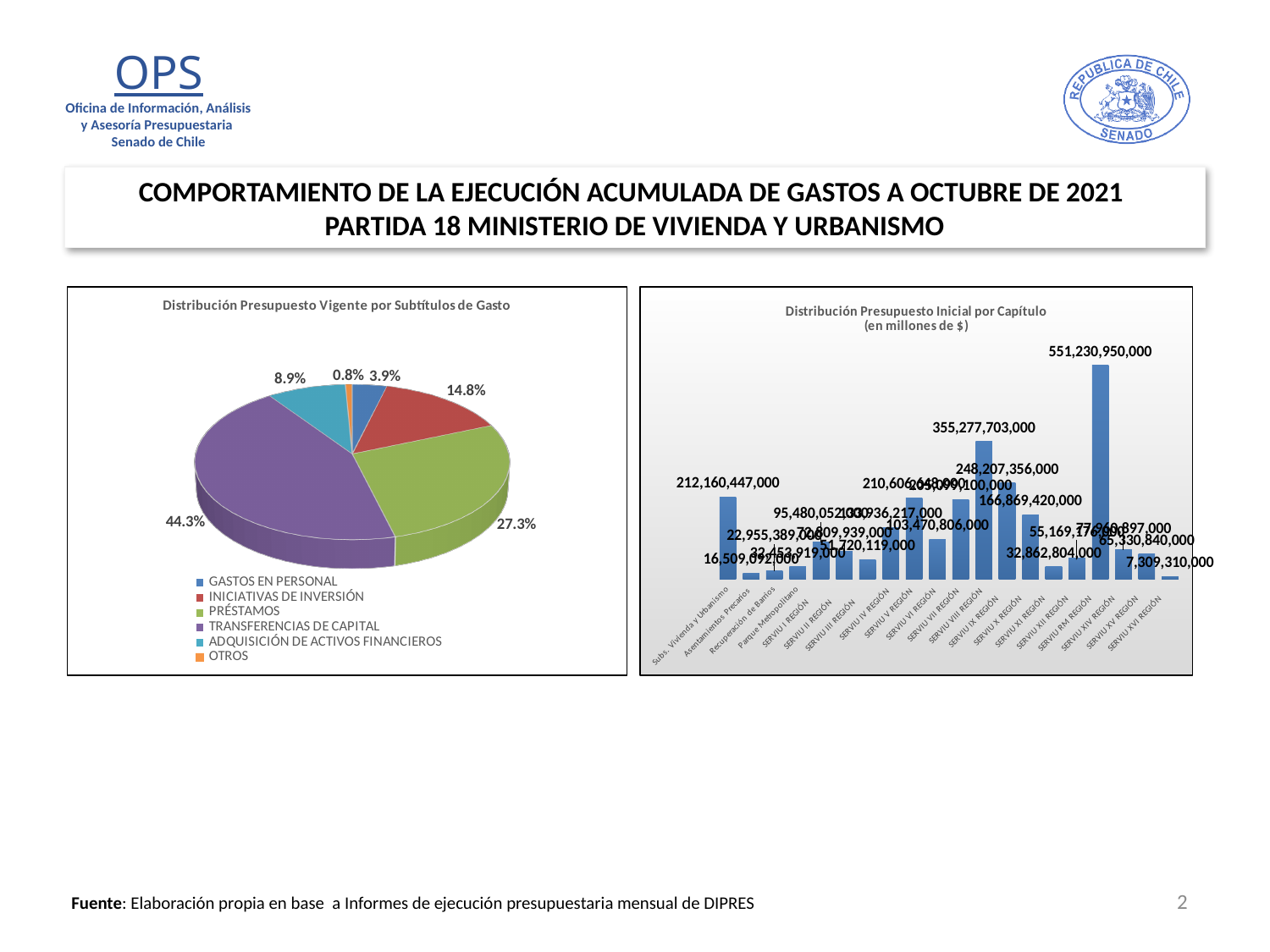
How many categories does the legend of the pie chart on the left list? 6 In the 'Distribución Presupuesto Inicial por Capítulo' chart, which category has the lowest value? SERVIU XVI REGIÓN In the pie chart on the left, what share does PRÉSTAMOS have? 27.3% What kind of chart is the 'Distribución Presupuesto Vigente por Subtítulos de Gasto' chart on the left? Pie chart In the 'Distribución Presupuesto Inicial por Capítulo' chart, which category has the highest value? SERVIU RM REGIÓN In the pie chart on the left, which category has the largest slice? TRANSFERENCIAS DE CAPITAL In the pie chart on the left, what share does TRANSFERENCIAS DE CAPITAL have? 44.3% In the pie chart on the left, which category has the smallest slice? OTROS In the pie chart on the left, which is larger: INICIATIVAS DE INVERSIÓN or ADQUISICIÓN DE ACTIVOS FINANCIEROS? INICIATIVAS DE INVERSIÓN In the 'Distribución Presupuesto Inicial por Capítulo' chart, what is the value for SERVIU VIII REGIÓN? 355,277,703,000 What kind of chart is the 'Distribución Presupuesto Inicial por Capítulo' chart on the right? Bar chart In the 'Distribución Presupuesto Inicial por Capítulo' chart, what is the value for SERVIU RM REGIÓN? 551,230,950,000